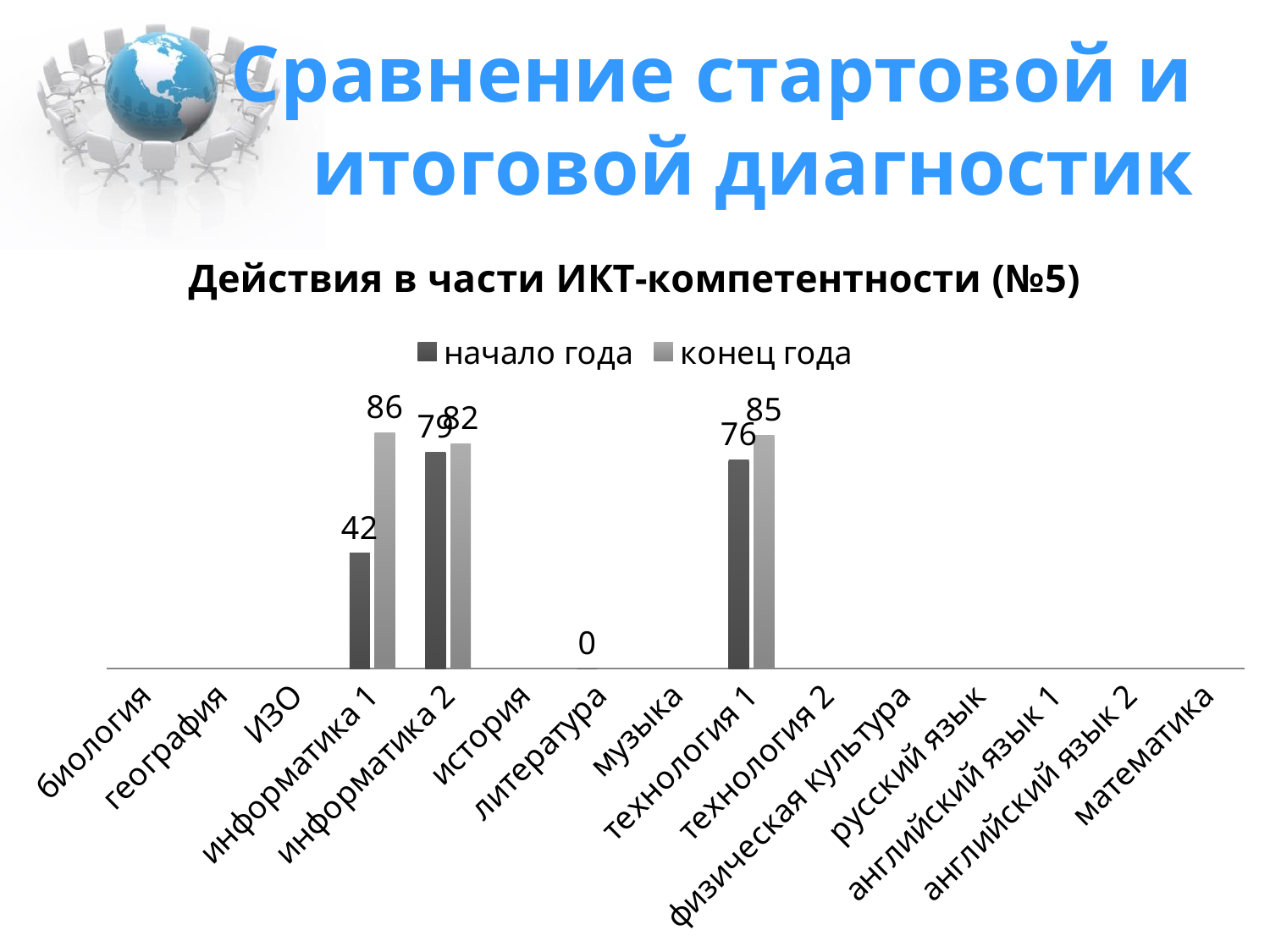
Which is larger for технология 1: the начало года value or the конец года value? конец года Which category has the highest value in the series конец года? информатика 1 What kind of chart is shown on the slide? bar chart What is the value for информатика 1 in the series начало года? 42 What is the value for технология 1 in the series конец года? 85 What is the value for технология 1 in the series начало года? 76 What is the title of the chart? Действия в части ИКТ-компетентности (№5) What are the two series named in the legend? начало года, конец года How many series does the legend list? 2 What is the difference between the конец года and начало года values for информатика 1? 44 What is the value for информатика 1 in the series конец года? 86 How many categories are shown on the x axis? 15